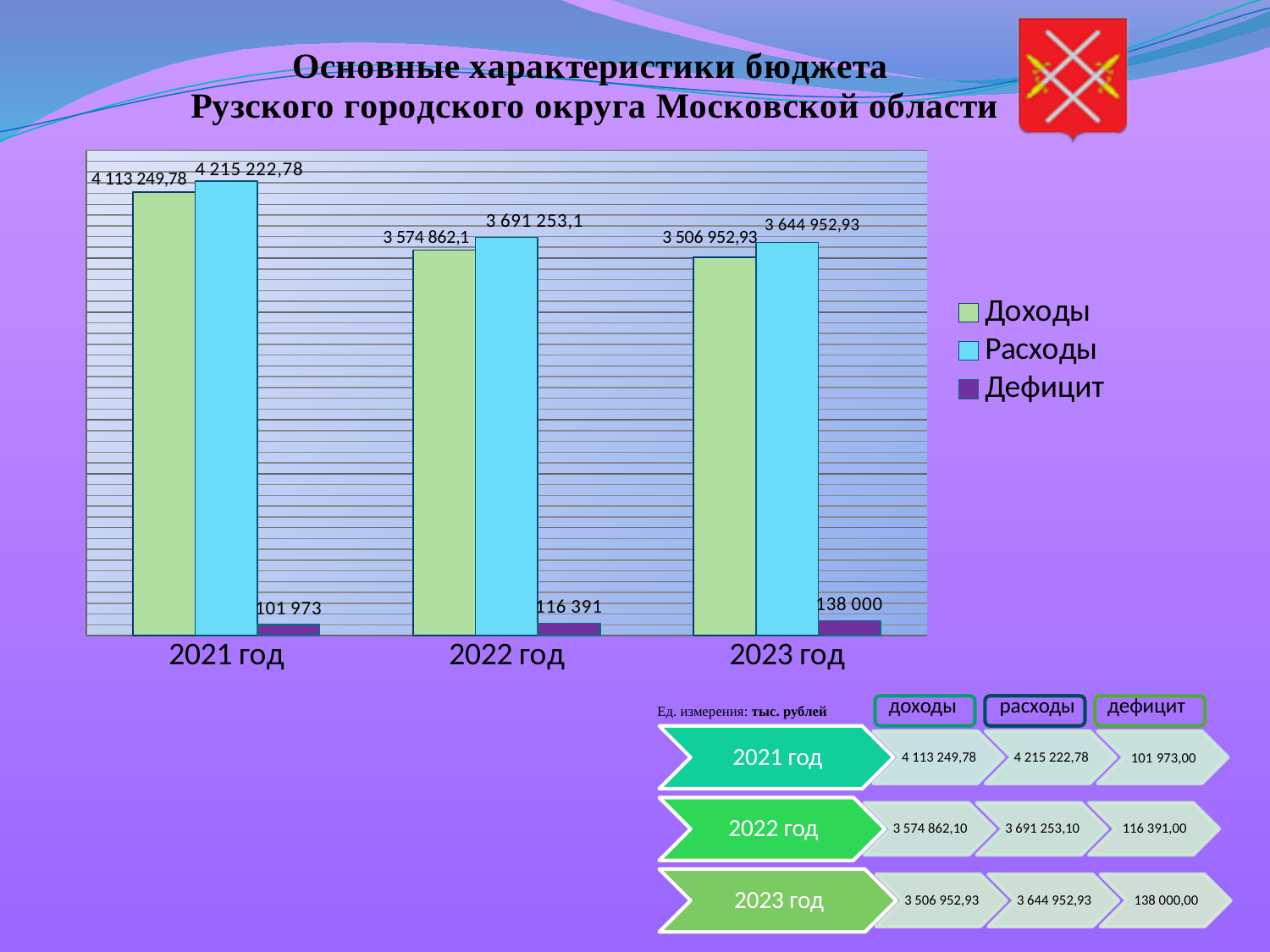
What is the value of Дефицит for 2023 год? 138 000 What is the value of Расходы for 2022 год? 3 691 253,1 In which year is Дефицит the lowest? 2021 год Which is larger for 2022 год: Доходы or Расходы? Расходы What is the difference between Расходы and Доходы for 2023 год? 138 000 How many years are shown on the x axis? 3 How many series does the legend list? 3 What kind of chart is shown on the slide? Bar chart In which year is Доходы the highest? 2021 год What is the value of Расходы for 2023 год? 3 644 952,93 What is the value of Доходы for 2021 год? 4 113 249,78 What is the difference between Дефицит in 2023 год and Дефицит in 2021 год? 36 027